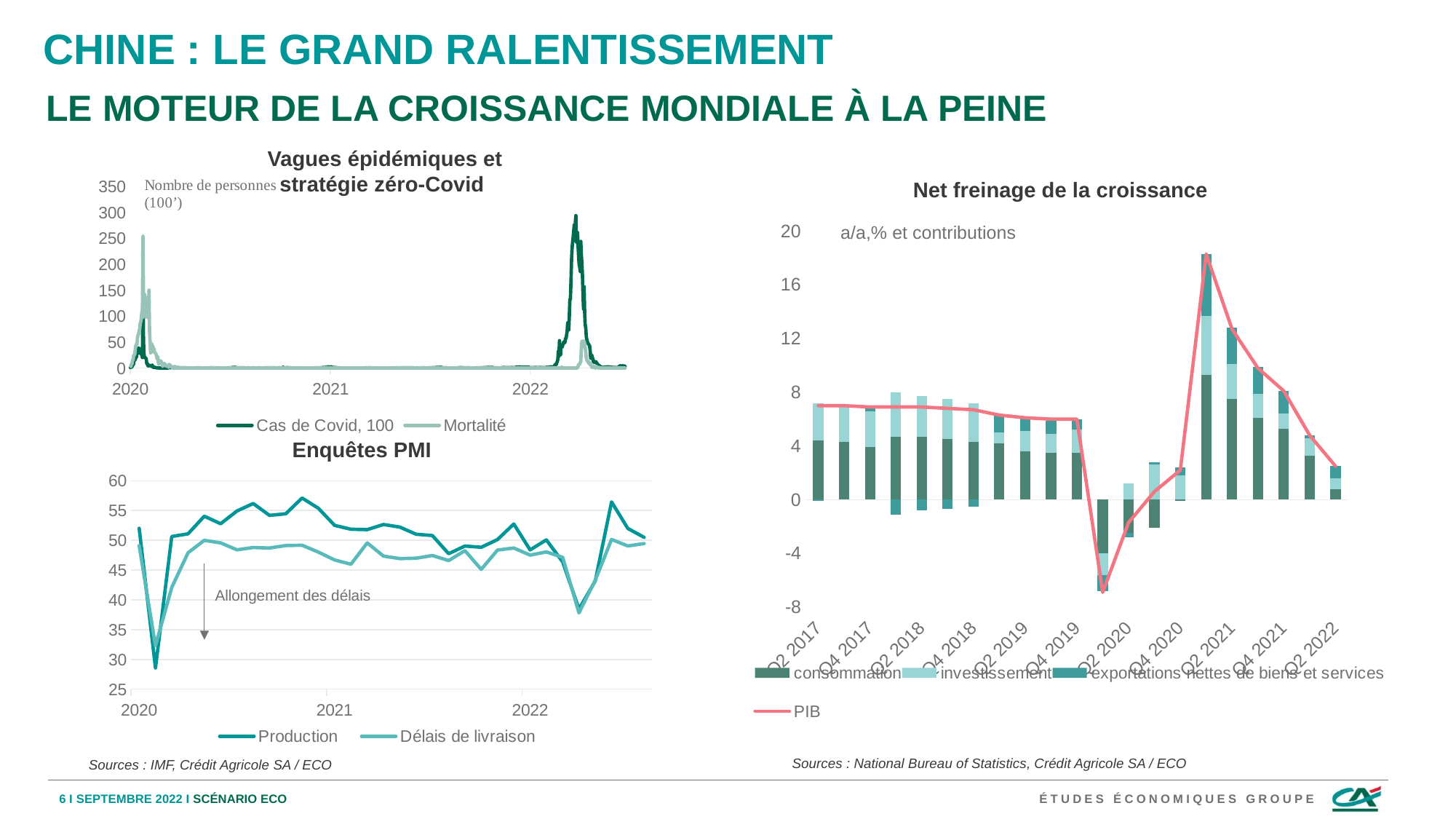
In the "Enquêtes PMI" chart, is the lowest value of "Production" in early 2020 greater or less than 35? less In the "Net freinage de la croissance" chart, does the PIB line rise or fall from Q2 2021 to Q2 2022? fall What unit label is shown on the "Net freinage de la croissance" chart? a/a,% et contributions How many series does the legend of the "Vagues épidémiques et stratégie zéro-Covid" chart list? 2 In the "Net freinage de la croissance" chart, is the PIB value at Q2 2020 greater or less than 0? less What are the legend entries of the "Net freinage de la croissance" chart? consommation, investissement, exportations nettes de biens et services, PIB In the "Enquêtes PMI" chart, which series is higher in mid-2021, "Production" or "Délais de livraison"? Production How many series does the legend of the "Net freinage de la croissance" chart list? 4 In the "Net freinage de la croissance" chart, is the PIB value at Q2 2021 greater or less than 16? greater In the "Vagues épidémiques et stratégie zéro-Covid" chart, which series reaches a higher peak in 2022, "Cas de Covid, 100" or "Mortalité"? Cas de Covid, 100 What kind of chart is the "Enquêtes PMI" chart? line chart